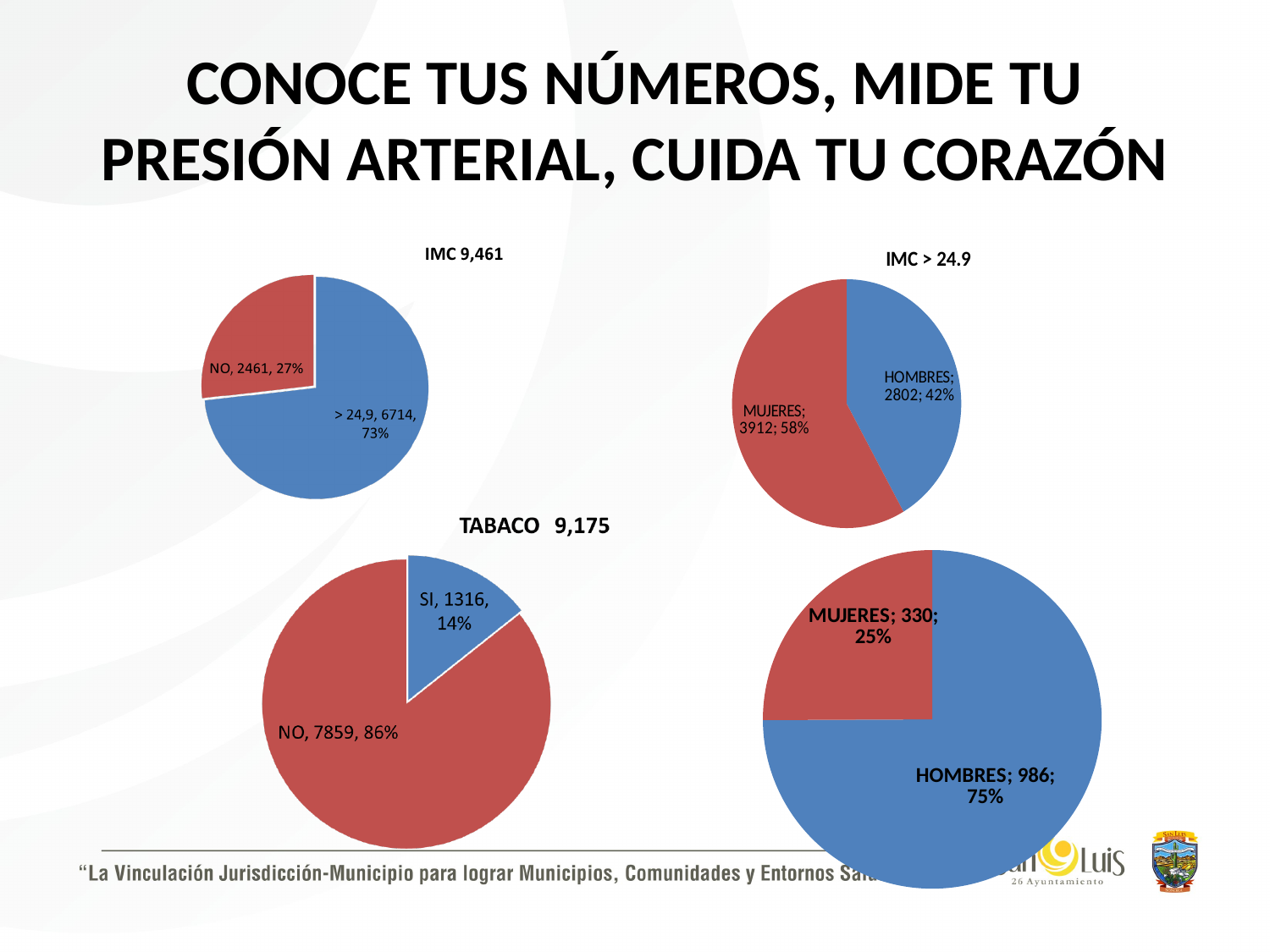
In the 'IMC > 24.9' chart, what is the difference between the MUJERES and HOMBRES values? 1110 In the 'IMC 9,461' chart, what percentage share does the 'NO' slice have? 27% In the 'IMC > 24.9' chart, what percentage share does the HOMBRES slice have? 42% In the 'IMC > 24.9' chart, what value is shown for MUJERES? 3912 In the untitled pie chart at the bottom right, what percentage share does the MUJERES slice have? 25% In the 'TABACO 9,175' chart, which slice is the largest? NO In the untitled pie chart at the bottom right, what value is shown for HOMBRES? 986 In the 'TABACO 9,175' chart, what value is shown for the 'SI' slice? 1316 In the 'IMC > 24.9' chart, which slice is larger, MUJERES or HOMBRES? MUJERES In the 'IMC 9,461' chart, what value is shown for the '> 24,9' slice? 6714 What type of chart is the 'TABACO 9,175' chart? Pie chart